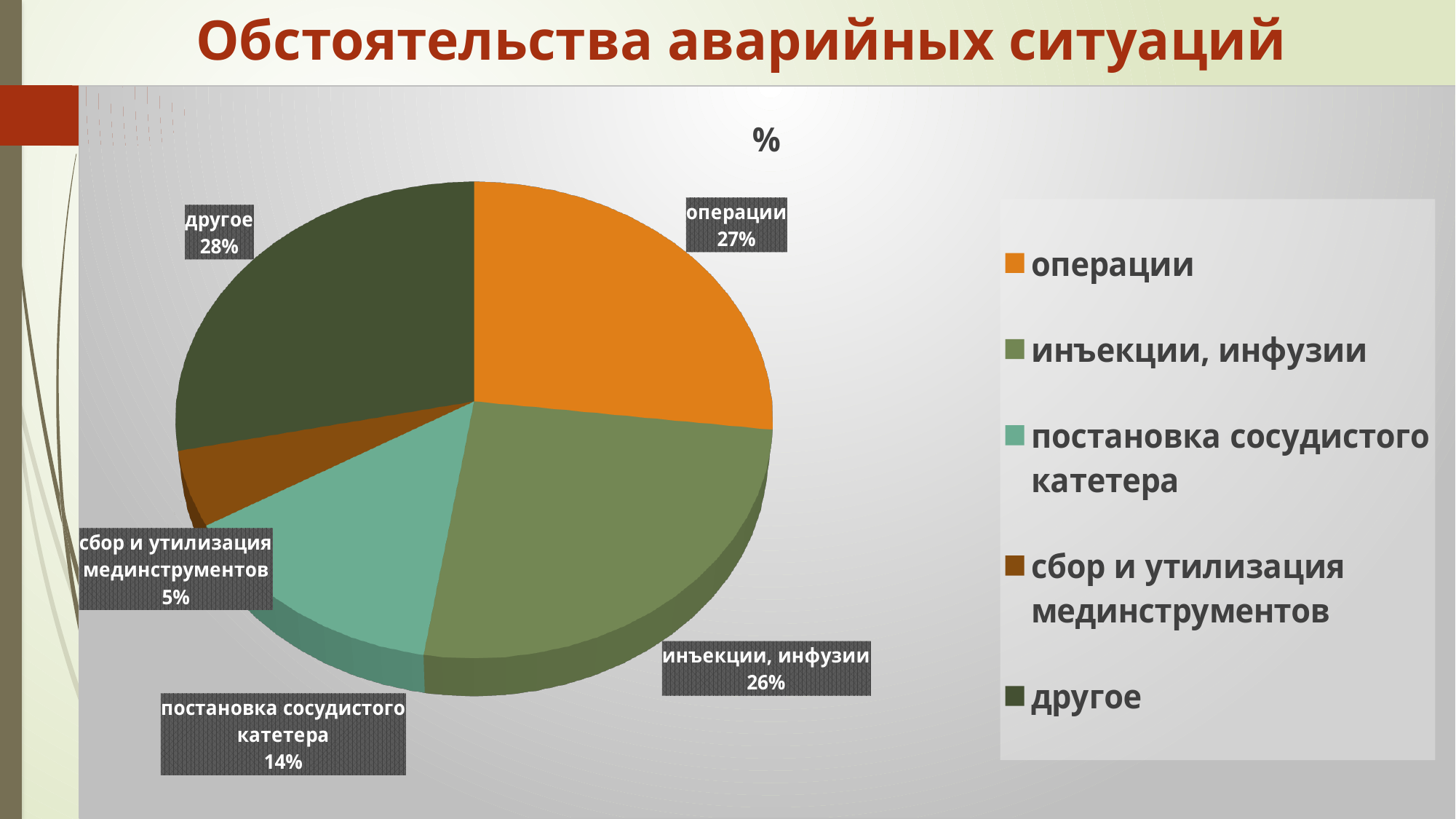
What is the difference between the shares of другое and сбор и утилизация мединструментов? 23% What is the title of the chart? % What percentage is shown for инъекции, инфузии? 26% Which category has the largest share of the pie? другое What percentage is shown for другое? 28% Which is larger: the share for операции or the share for постановка сосудистого катетера? операции What percentage is shown for постановка сосудистого катетера? 14% How many categories does the pie chart have? 5 What percentage is shown for операции? 27% Which category has the smallest share of the pie? сбор и утилизация мединструментов What type of chart is shown on the slide? pie chart What percentage is shown for сбор и утилизация мединструментов? 5%